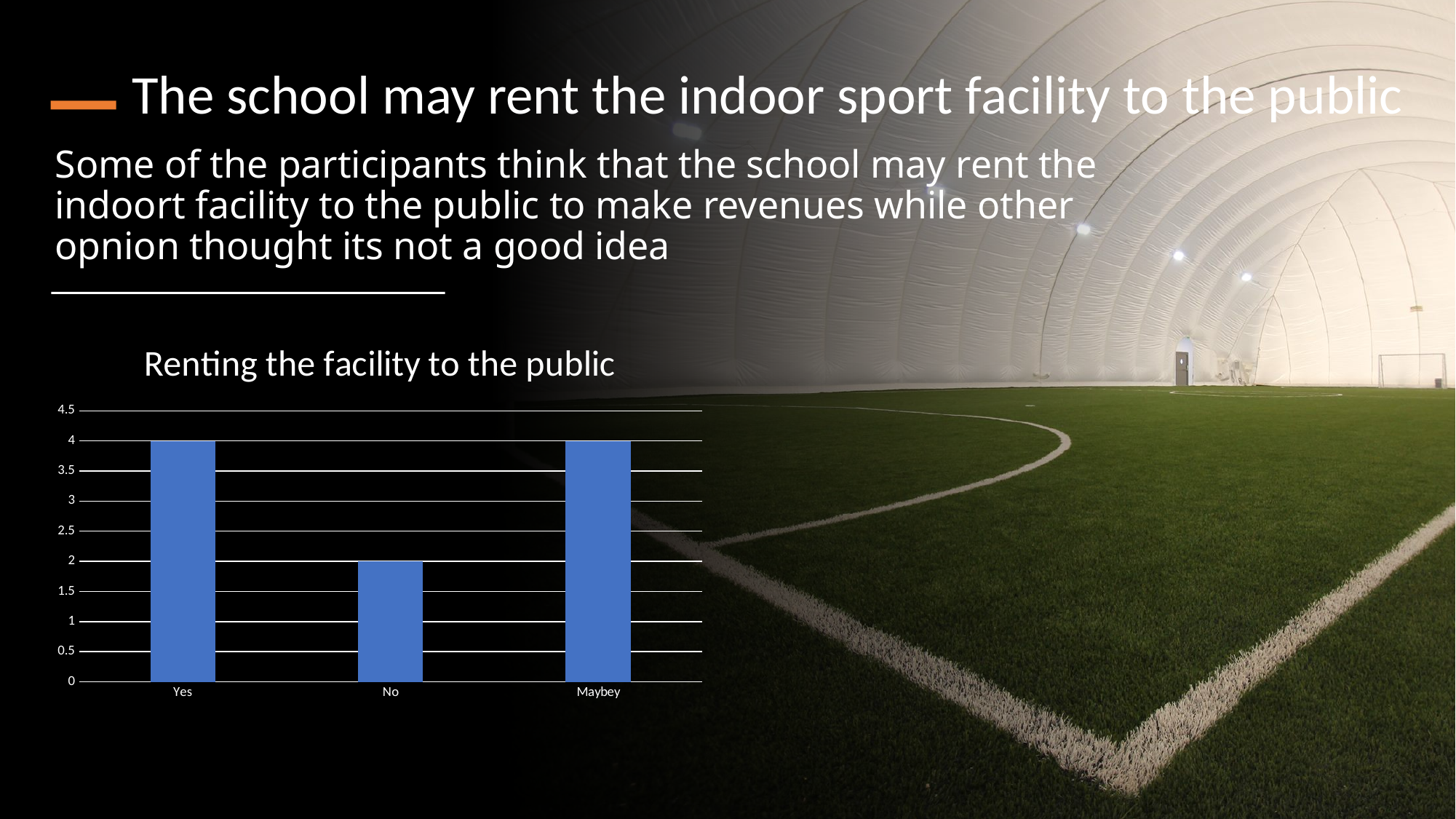
What is the value for Maybey in the chart? 4 What kind of chart is shown on the slide? bar chart What is the value for No in the chart? 2 What is the title of the chart? Renting the facility to the public Which category has the lowest value in the chart? No Which is larger, the value for No or the value for Maybey? Maybey Which is larger, the value for Yes or the value for No? Yes What is the difference between the values for Yes and No? 2 How many categories are shown in the chart? 3 Is the value for No greater or less than 3? less Is the value for Maybey greater or less than 3? greater What is the value for Yes in the chart? 4